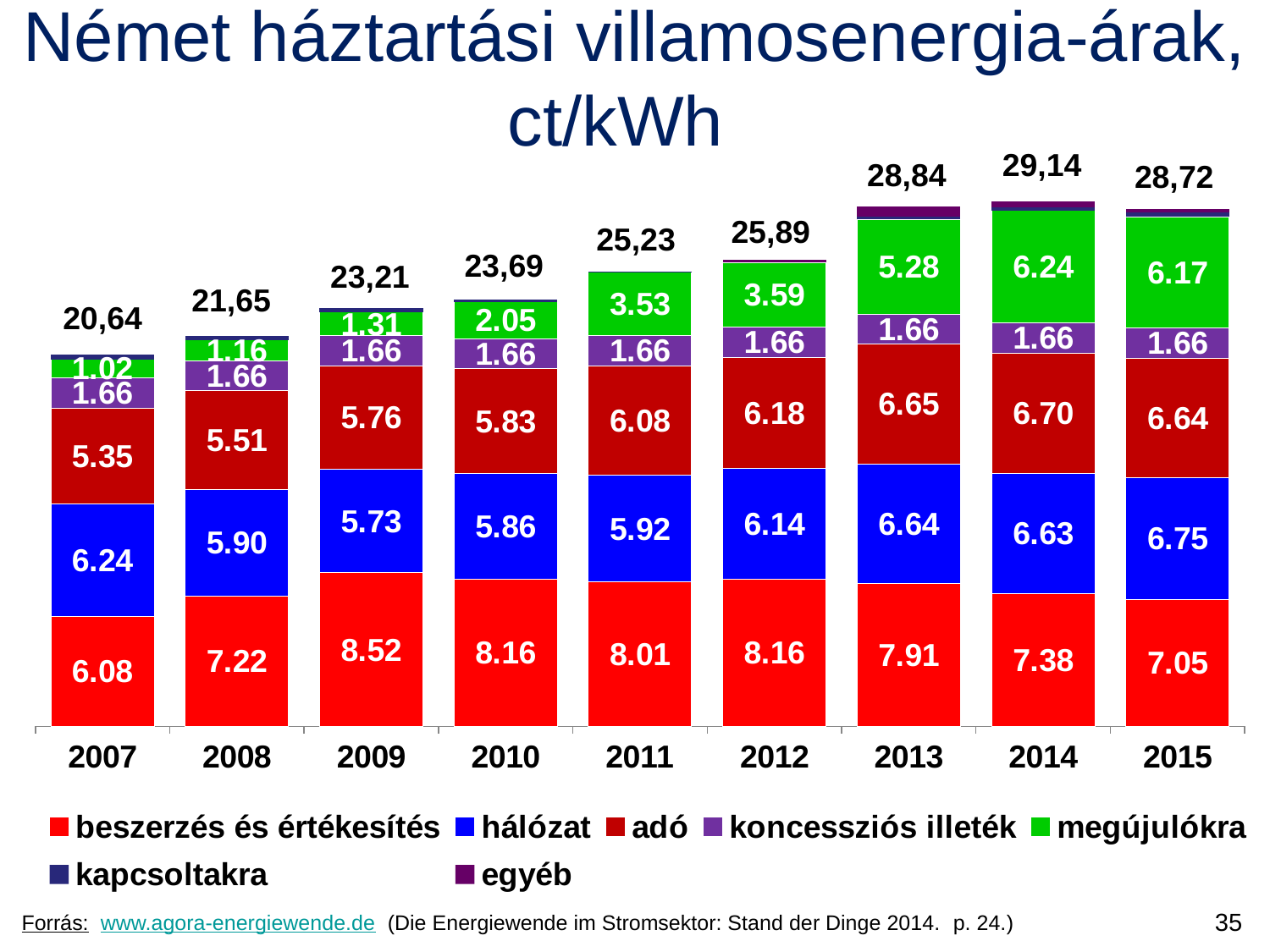
What is the total value printed above the bar for 2014? 29,14 Which year has the highest total printed above its bar? 2014 How many years are shown on the x axis? 9 How many series does the legend list? 7 What is the difference between the 'adó' segment in 2014 and in 2007? 1.35 What type of chart is shown on the slide? stacked bar chart Which is larger: the 'beszerzés és értékesítés' segment in 2010 or in 2015? 2010 Which year has the lowest total printed above its bar? 2007 What is the value of the 'hálózat' segment in 2012? 6.14 What is the value of the 'megújulókra' segment in 2015? 6.17 Do the totals printed above the bars rise or fall from 2007 to 2014? rise What is the value of the 'beszerzés és értékesítés' segment in 2009? 8.52